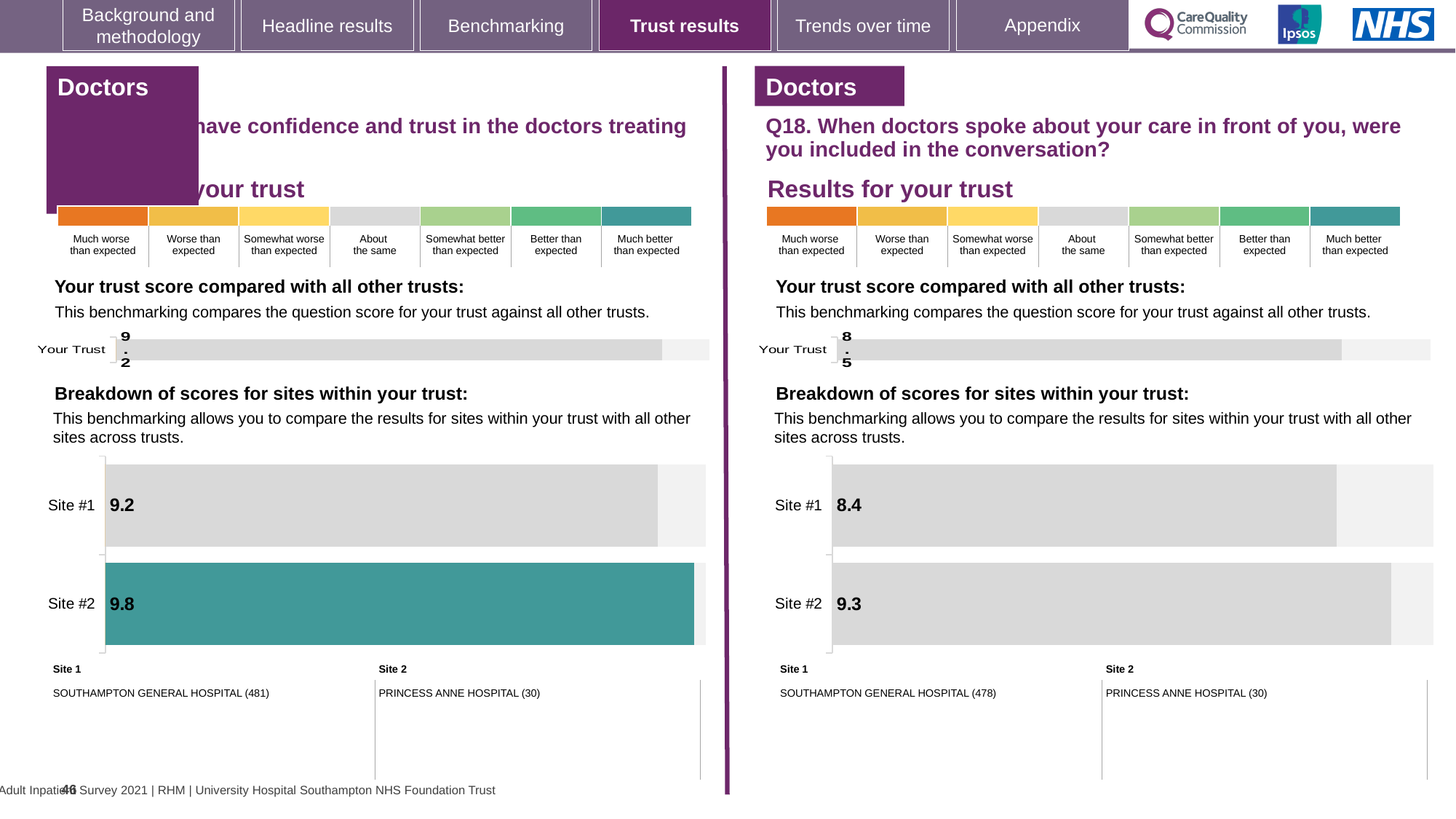
In the Q18 site breakdown chart on the right, what is the difference between the Site #2 and Site #1 scores? 0.9 In the left-hand 'Your trust score compared with all other trusts' chart, what is the value for Your Trust? 9.2 In the left-hand site breakdown chart, what is the score for Site #2? 9.8 What type of chart is used for the site breakdown on the left-hand side of the slide? Bar chart In the Q18 site breakdown chart on the right, which site has the lower score? Site #1 How many sites are shown in the Q18 site breakdown chart on the right? 2 In the left-hand site breakdown chart, what is the score for Site #1? 9.2 In the Q18 site breakdown chart on the right, what is the score for Site #2? 9.3 In the Q18 'Your trust score compared with all other trusts' chart on the right, what is the value for Your Trust? 8.5 In the left-hand site breakdown chart, what is the difference between the Site #2 and Site #1 scores? 0.6 In the left-hand site breakdown chart, which site has the higher score? Site #2 In the Q18 site breakdown chart on the right, what is the score for Site #1? 8.4